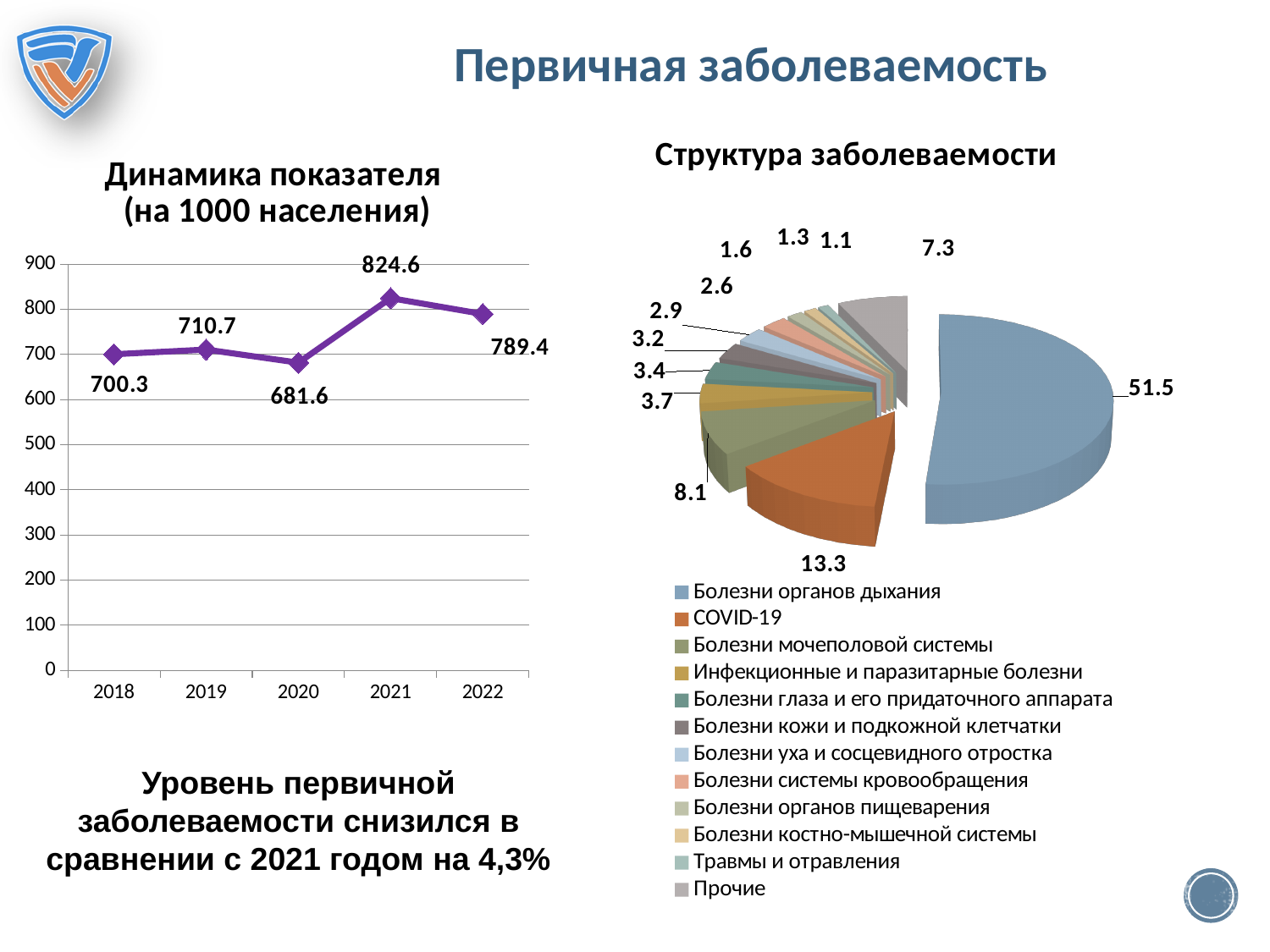
On the line chart 'Динамика показателя (на 1000 населения)', is the value for 2019 greater or less than 800? less On the line chart 'Динамика показателя (на 1000 населения)', which year has the highest value? 2021 How many entries does the legend of the pie chart 'Структура заболеваемости' list? 12 On the line chart 'Динамика показателя (на 1000 населения)', does the value rise or fall from 2021 to 2022? fall On the pie chart 'Структура заболеваемости', what is the value for 'Болезни органов дыхания'? 51.5 On the pie chart 'Структура заболеваемости', what is the value for 'COVID-19'? 13.3 On the line chart 'Динамика показателя (на 1000 населения)', what is the value for 2021? 824.6 On the line chart 'Динамика показателя (на 1000 населения)', what is the value for 2018? 700.3 On the line chart 'Динамика показателя (на 1000 населения)', which year has the lowest value? 2020 What type of chart is 'Структура заболеваемости'? pie chart On the line chart 'Динамика показателя (на 1000 населения)', how many years are plotted? 5 On the line chart 'Динамика показателя (на 1000 населения)', what is the difference between the 2021 and 2022 values? 35.2